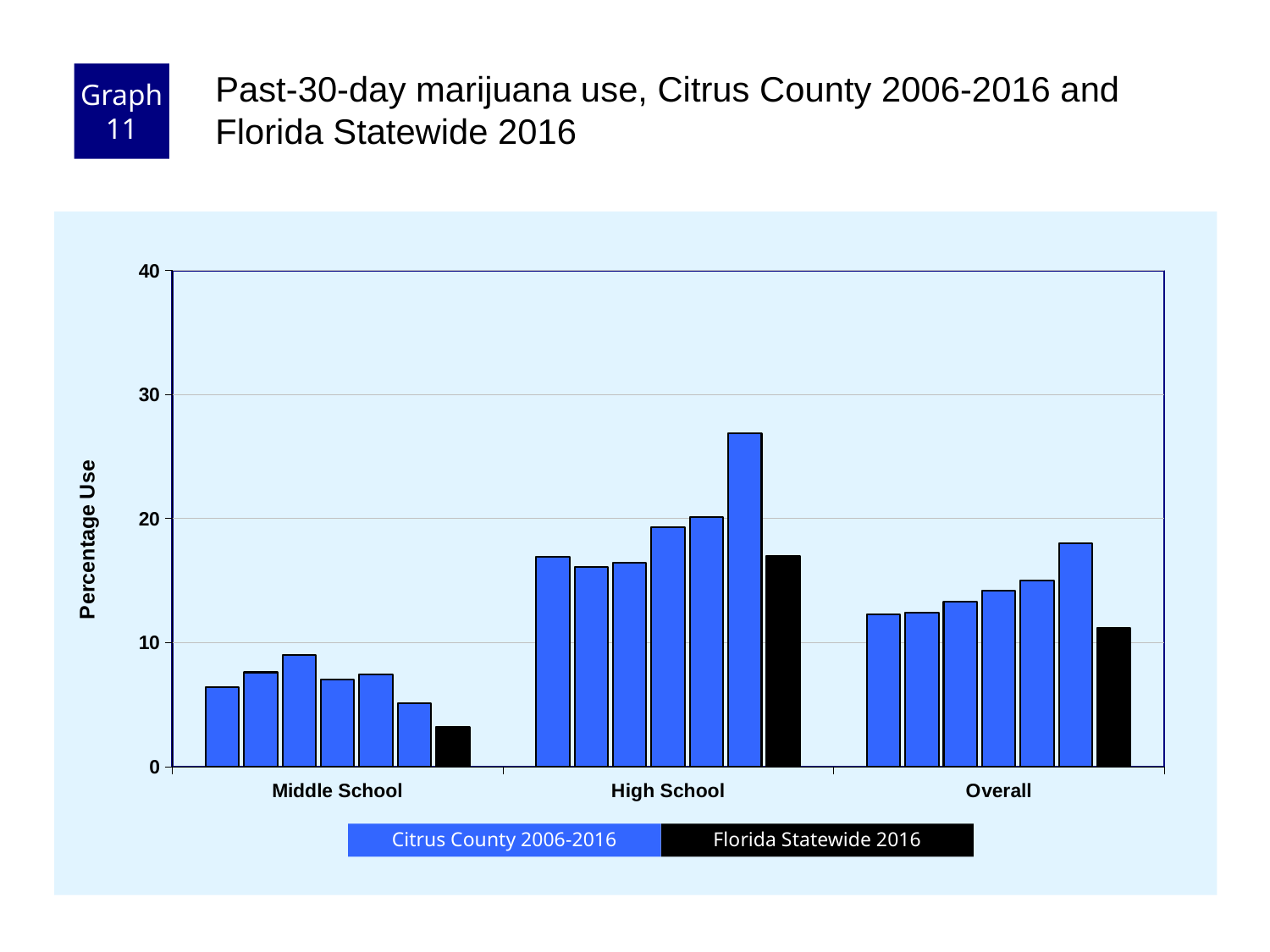
Is the tallest Citrus County 2006-2016 bar in the Middle School group greater or less than 10? less Is the tallest Citrus County 2006-2016 bar in the High School group greater or less than 20? greater Which category has the highest Florida Statewide 2016 value? High School Is the Florida Statewide 2016 value for Middle School greater or less than 10? less How many Citrus County 2006-2016 bars are shown in the High School group? 6 What is the label on the y axis? Percentage Use How many series does the legend list? 2 What kind of chart is shown on the slide? bar chart Which category has the lowest Florida Statewide 2016 value? Middle School How many categories are shown on the x axis? 3